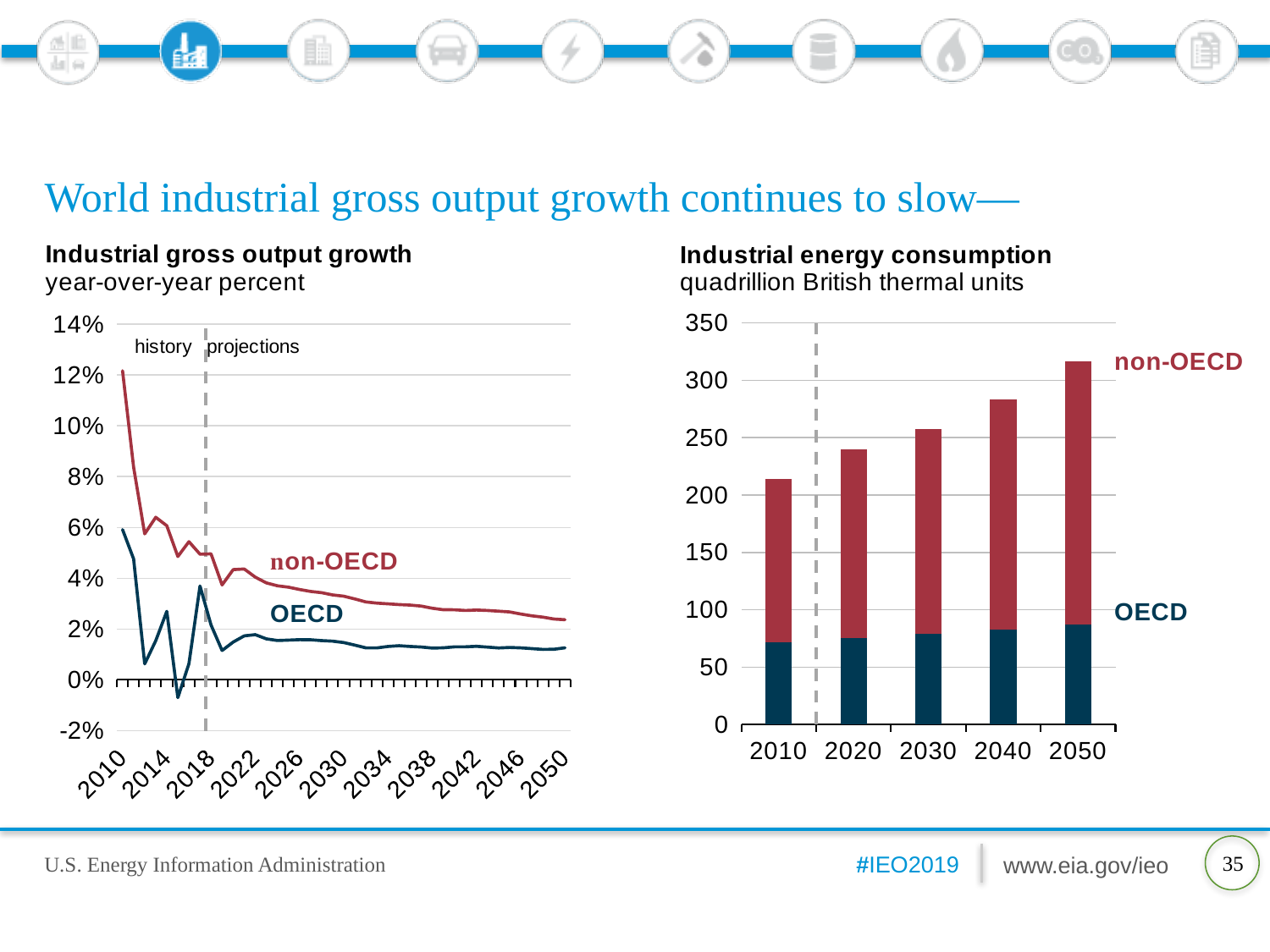
In the 'Industrial energy consumption' chart, is the total value for 2010 greater or less than 250? less In the 'Industrial gross output growth' chart, what unit is shown on the y axis? year-over-year percent In the 'Industrial energy consumption' chart, how many years (bars) are plotted? 5 In the 'Industrial energy consumption' chart, which year has the tallest total bar? 2050 In the 'Industrial energy consumption' chart, how many series are stacked in each bar? 2 In the 'Industrial energy consumption' chart, which year has the shortest total bar? 2010 In the 'Industrial gross output growth' chart, does the non-OECD line generally rise or fall from 2010 to 2050? fall In the 'Industrial energy consumption' chart, is the OECD value for 2050 greater or less than 100? less In the 'Industrial energy consumption' chart, is the total value for 2050 greater or less than 300? greater In the 'Industrial gross output growth' chart, which series is higher in 2050, non-OECD or OECD? non-OECD In the 'Industrial energy consumption' chart, what kind of chart is shown? bar chart In the 'Industrial gross output growth' chart, what kind of chart is shown? line chart